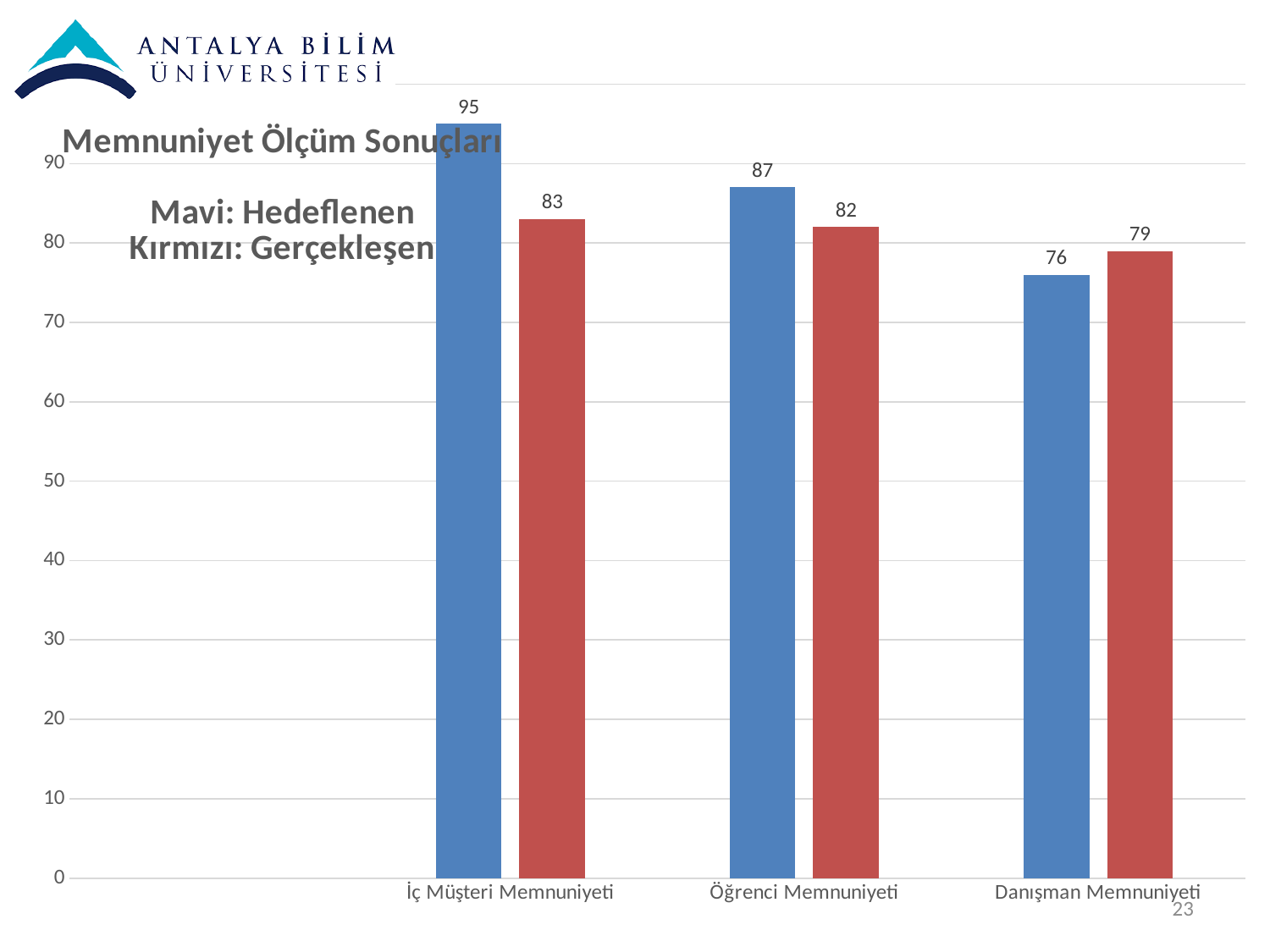
What is the targeted (Hedeflenen, blue) value for İç Müşteri Memnuniyeti? 95 For Danışman Memnuniyeti, which is larger: the targeted (blue) value or the realised (red) value? the realised (red) value According to the slide text, what does the red colour represent? Gerçekleşen What is the realised (Gerçekleşen, red) value for Öğrenci Memnuniyeti? 82 Which category has the highest targeted (blue) value? İç Müşteri Memnuniyeti Which category has the lowest targeted (blue) value? Danışman Memnuniyeti What type of chart is shown on the slide? bar chart What is the difference between the targeted and realised values for Öğrenci Memnuniyeti? 5 What is the realised (Gerçekleşen, red) value for Danışman Memnuniyeti? 79 How many categories are shown on the x axis of the chart? 3 What is the difference between the targeted and realised values for İç Müşteri Memnuniyeti? 12 Is the targeted (blue) value for Danışman Memnuniyeti greater or less than 80? less